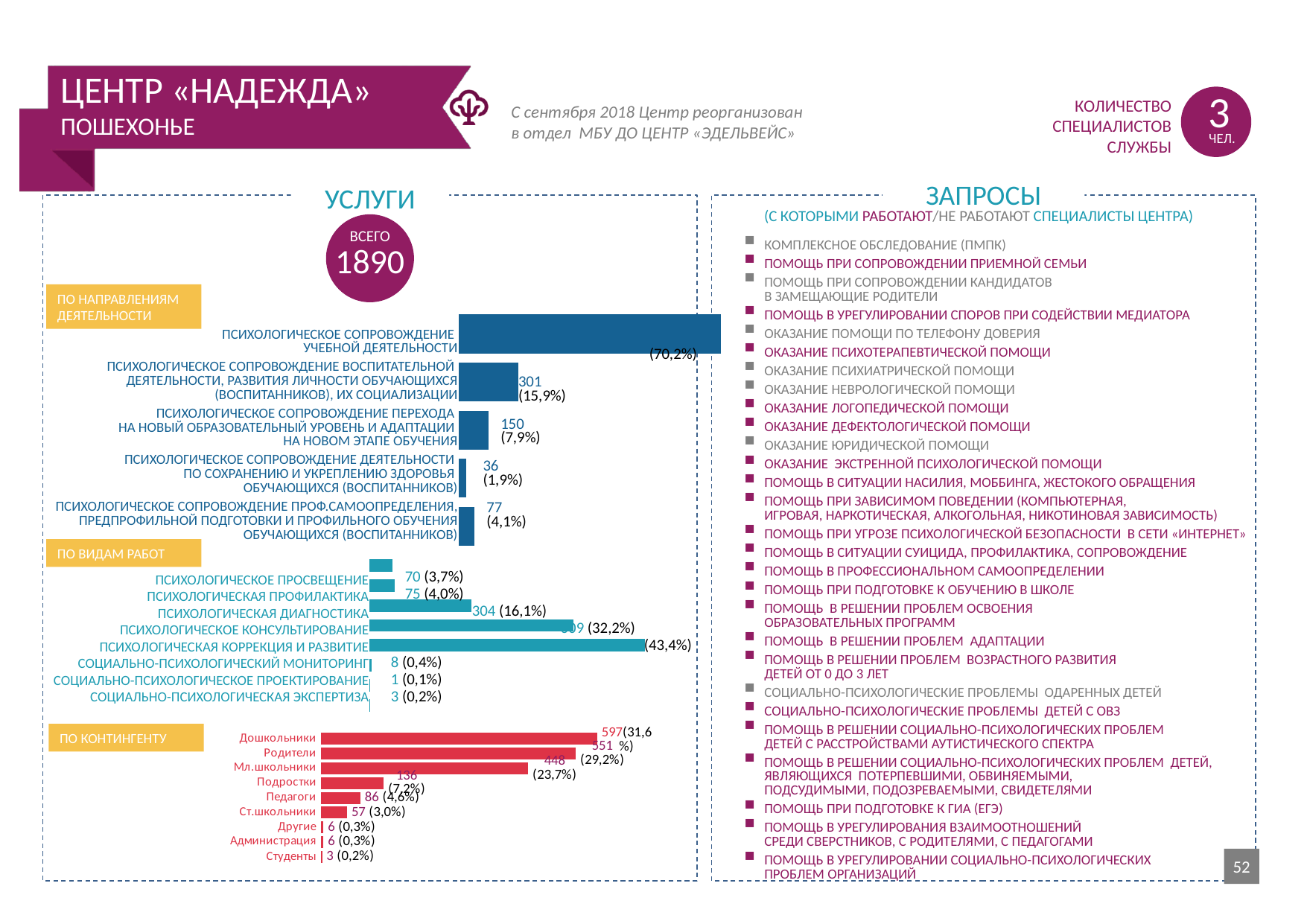
What type of chart is used in the 'По контингенту' section? Bar chart In the 'По контингенту' chart, how many categories are shown? 9 In the 'По контингенту' chart, what is the difference between the values for Дошкольники and Родители? 46 In the 'По направлениям деятельности' chart, what percentage is shown for Психологическое сопровождение учебной деятельности? 70,2% In the 'По контингенту' chart, what is the value for Родители? 551 In the 'По контингенту' chart, which category has the highest value? Дошкольники In the 'По видам работ' chart, which is larger: Психологическое просвещение or Психологическая профилактика? Психологическая профилактика In the 'По видам работ' chart, what is the value for Психологическая диагностика? 304 In the 'По видам работ' chart, which category has the lowest value? Социально-психологическое проектирование In the 'По контингенту' chart, what percentage is shown for Мл.школьники? 23,7% In the 'По контингенту' chart, which category has the lowest value? Студенты In the 'По направлениям деятельности' chart, what is the value for Психологическое сопровождение перехода на новый образовательный уровень? 150